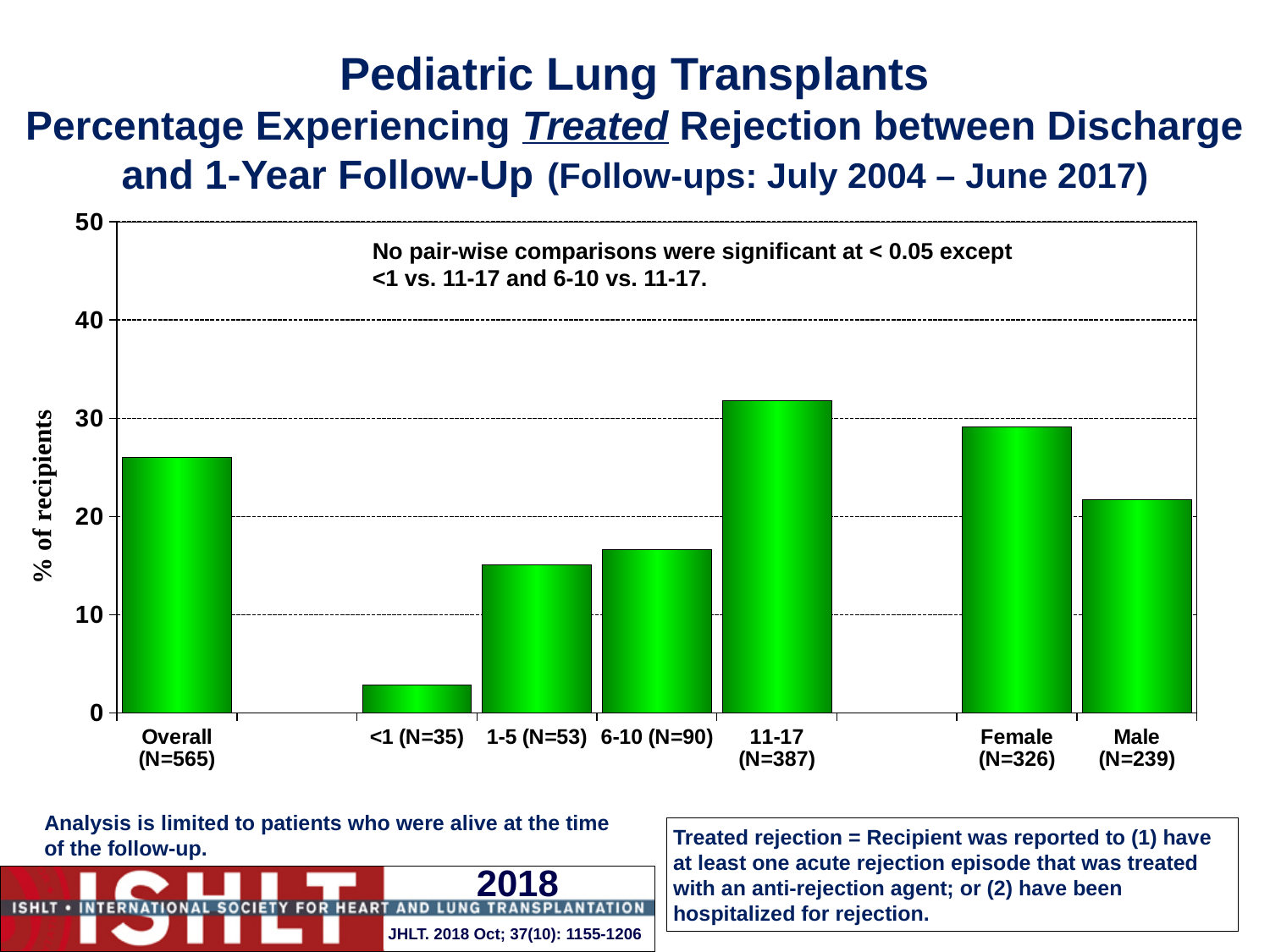
Is the value for Male (N=239) greater or less than 30? less Is the value for 11-17 (N=387) greater or less than 30? greater How many bars are plotted in the chart? 7 Is the value for <1 (N=35) greater or less than 10? less Which has a higher percentage of recipients with treated rejection, 1-5 (N=53) or 11-17 (N=387)? 11-17 (N=387) Which category has the lowest percentage of recipients experiencing treated rejection? <1 (N=35) What is the label on the y axis of the chart? % of recipients Which category has the highest percentage of recipients experiencing treated rejection? 11-17 (N=387) What kind of chart is shown on the slide? bar chart Across the age groups from <1 to 11-17, do the values rise or fall? rise Which has a higher percentage of recipients with treated rejection, Female or Male? Female